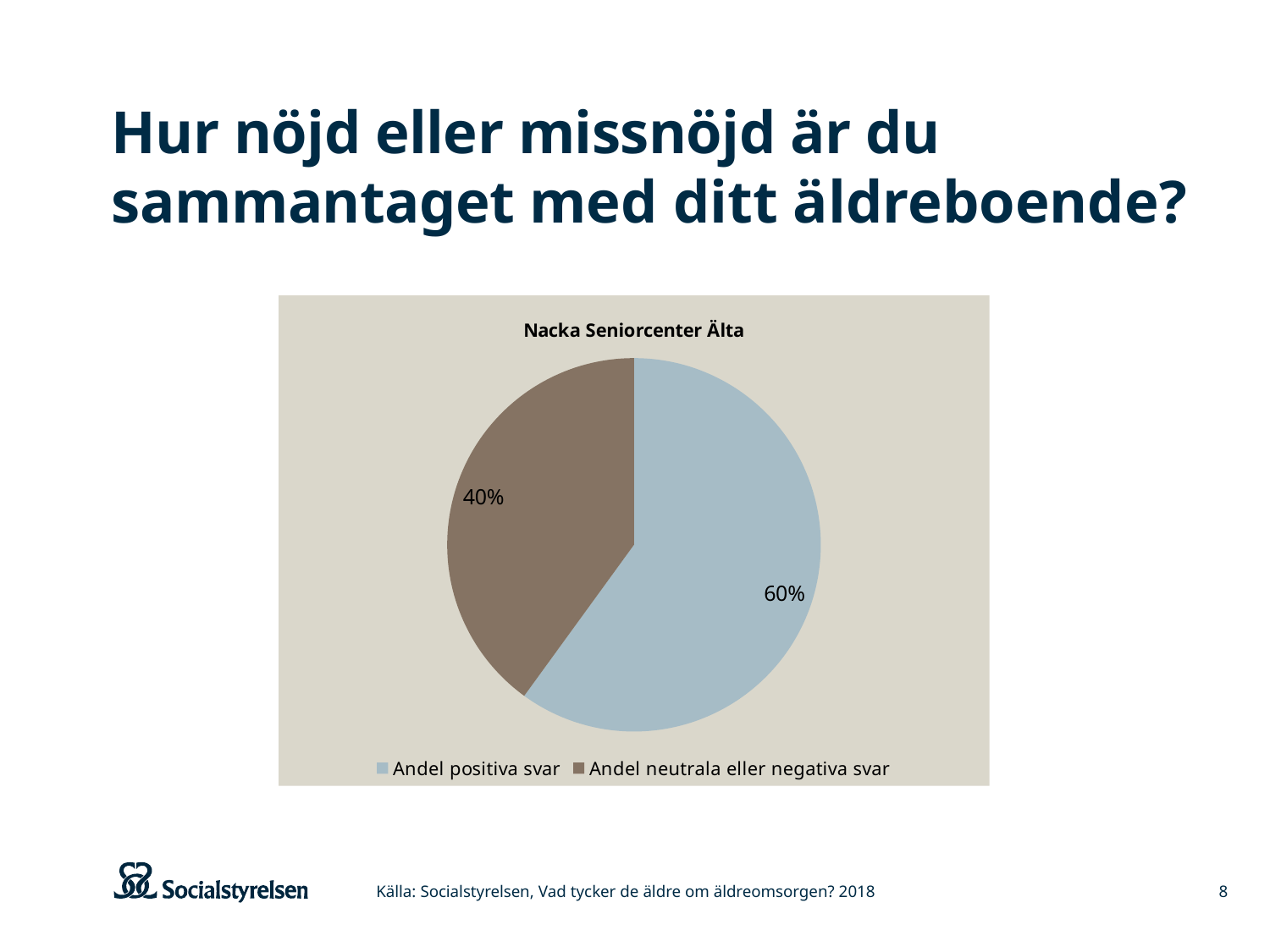
What kind of chart is shown on the slide? pie chart What is the difference in percentage points between 'Andel positiva svar' and 'Andel neutrala eller negativa svar'? 20 percentage points Which is larger, 'Andel positiva svar' or 'Andel neutrala eller negativa svar'? Andel positiva svar How many entries does the legend list? 2 What share of the pie is 'Andel neutrala eller negativa svar'? 40% Which legend entry is shown in brown? Andel neutrala eller negativa svar Which slice is the smallest? Andel neutrala eller negativa svar What share of the pie is 'Andel positiva svar'? 60% How many slices does the pie chart have? 2 Which slice is the largest? Andel positiva svar Is the share for 'Andel positiva svar' greater or less than 50%? greater What is the chart's title? Nacka Seniorcenter Älta